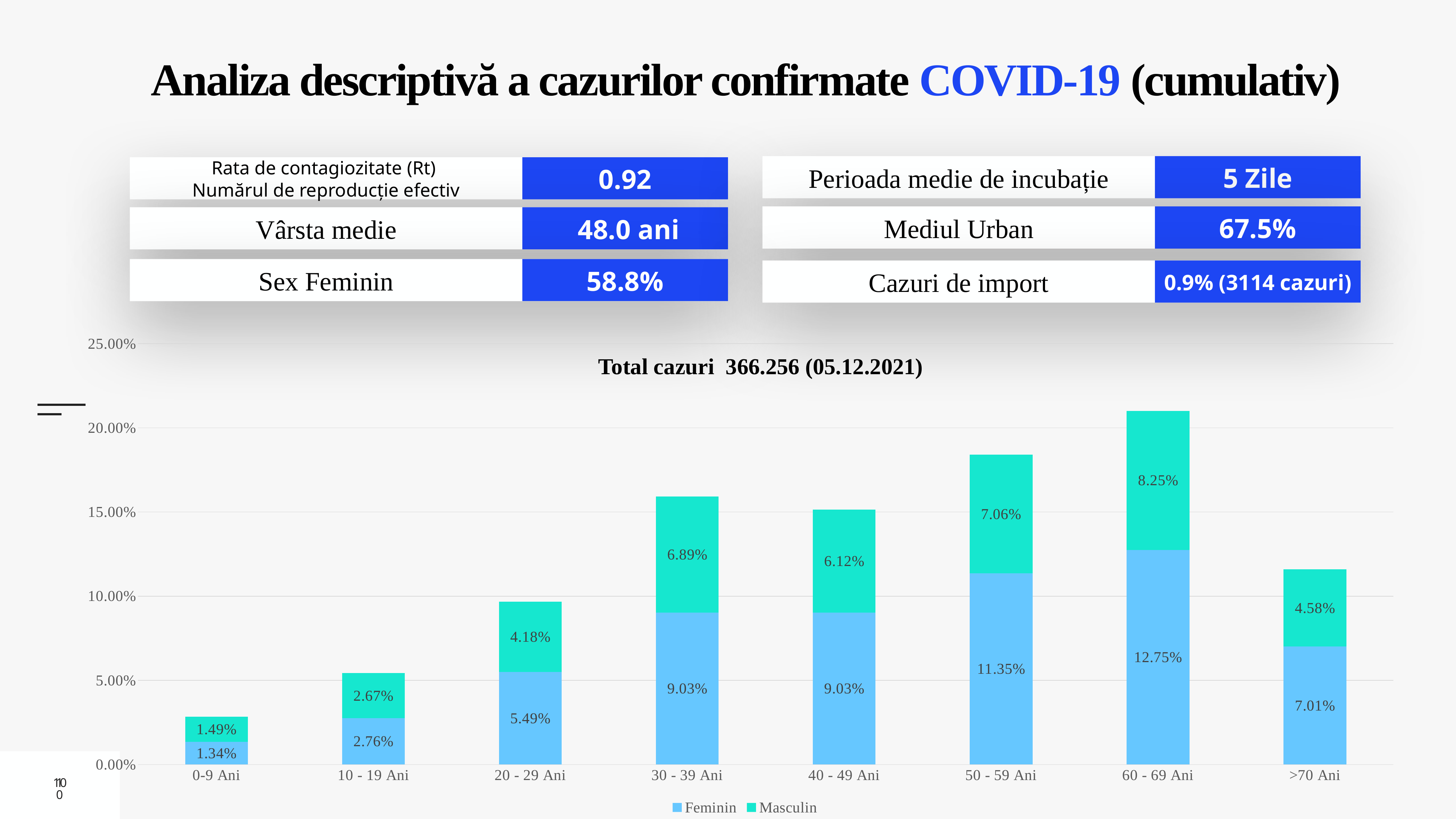
What kind of chart is shown on the slide? stacked bar chart How many age groups are shown on the x axis of the chart? 8 What is the total of the stacked bar for the 60 - 69 Ani age group? 21.00% Which is larger, the Masculin value for 30 - 39 Ani or the Masculin value for 40 - 49 Ani? 30 - 39 Ani What is the Feminin value for the 60 - 69 Ani age group? 12.75% What is the difference between the Feminin and Masculin values for the 50 - 59 Ani age group? 4.29% Is the total stacked bar for the 50 - 59 Ani age group greater or less than 15.00%? greater Which age group has the lowest Feminin value? 0-9 Ani What is the Feminin value for the >70 Ani age group? 7.01% Which age group has the highest Masculin value? 60 - 69 Ani How many series does the chart legend list? 2 What is the Masculin value for the 20 - 29 Ani age group? 4.18%